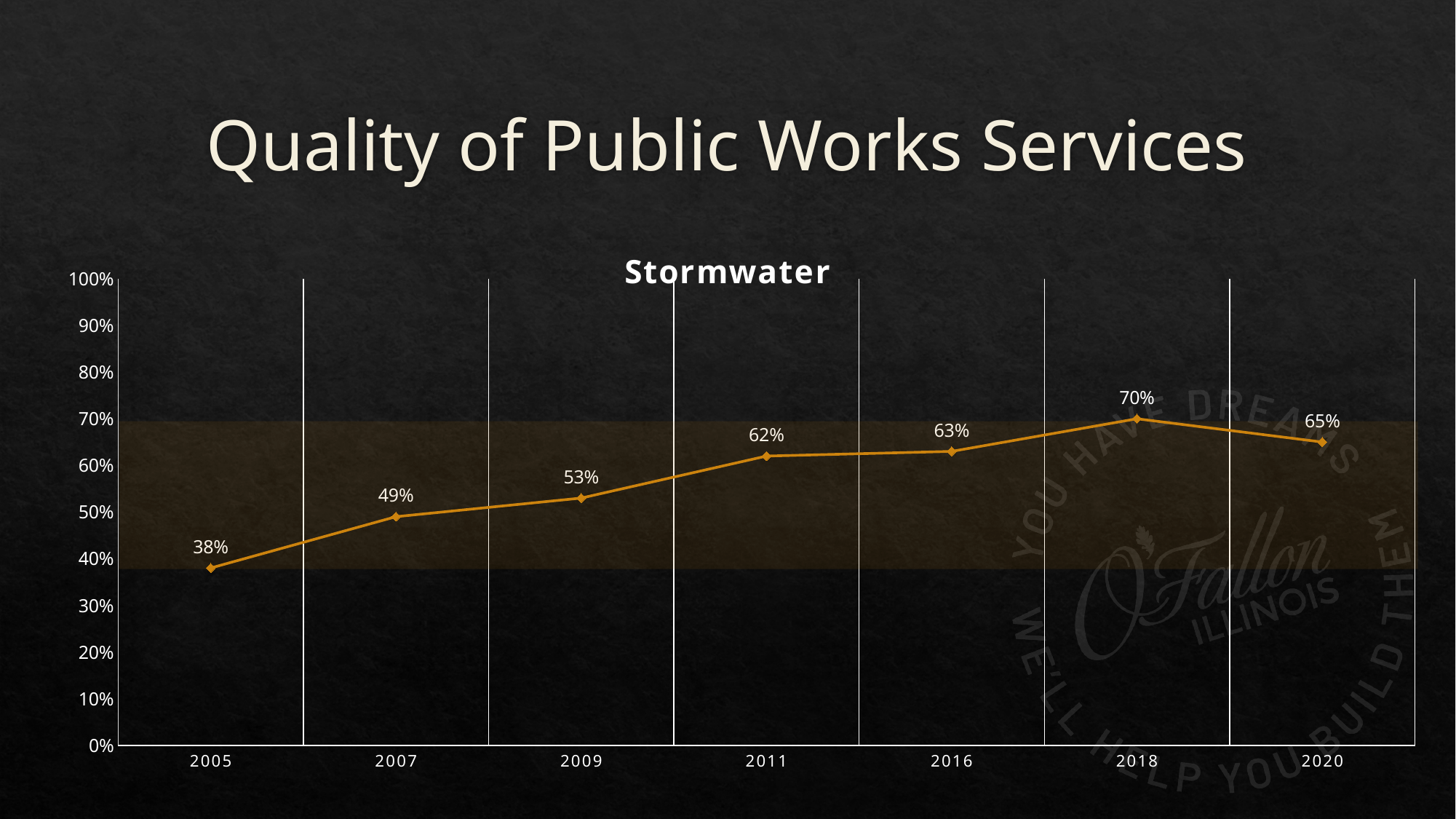
What is the value for 2011? 62% How many years are plotted on the chart? 7 What kind of chart is shown? line chart Do the values rise or fall from 2005 to 2018? rise Which is larger, the value for 2016 or the value for 2020? 2020 What is the difference between the values for 2018 and 2005? 32% Which year has the lowest value? 2005 What is the value for 2005? 38% Is the value for 2009 greater or less than 60%? less What is the title of the chart? Stormwater What is the value for 2020? 65% Which year has the highest value? 2018